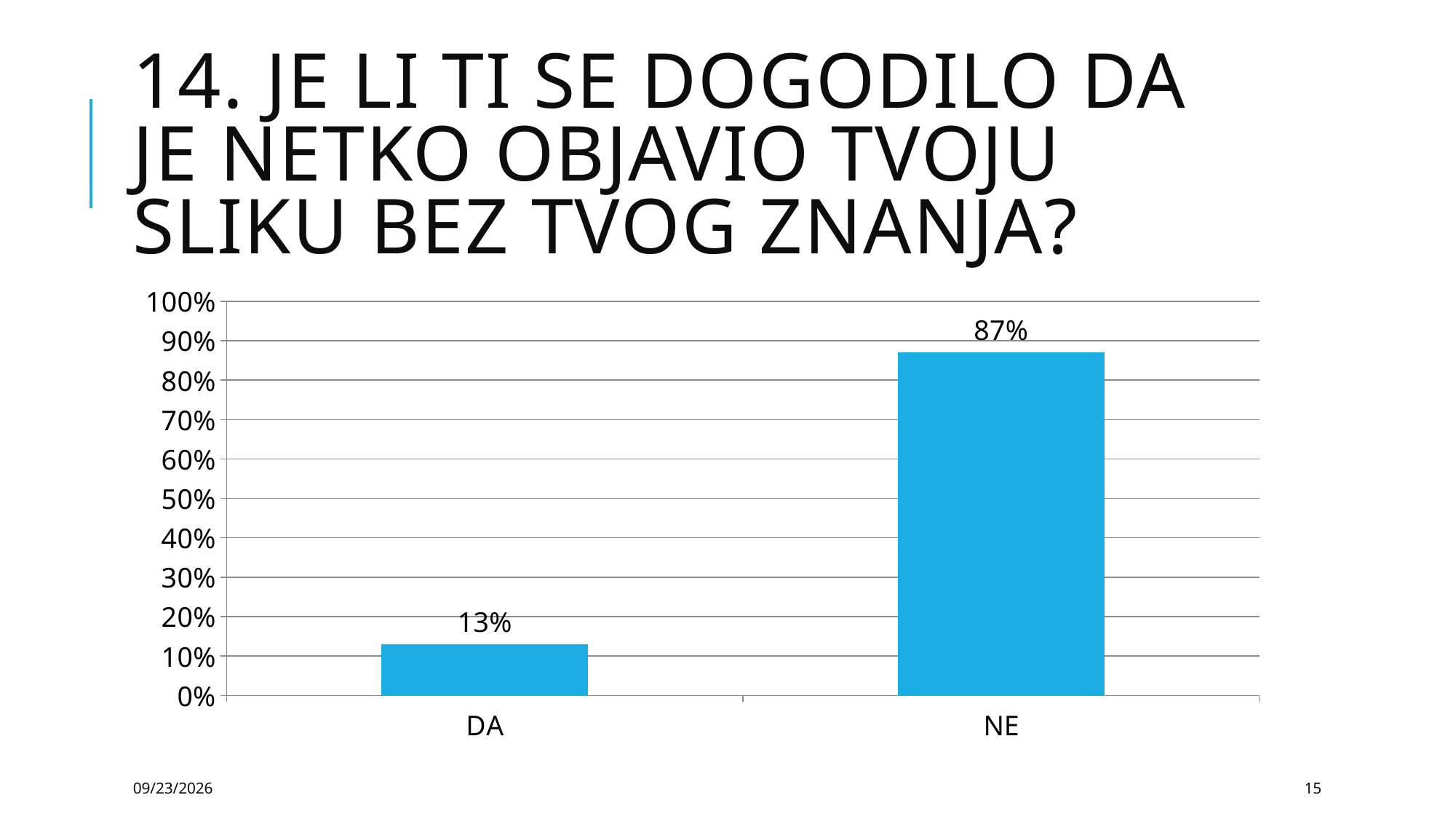
How many categories are shown on the x axis? 2 Which category has the lowest value? DA Is the value for DA greater or less than 20%? less What is the value for DA? 13% Which category has the highest value? NE What is the value for NE? 87% What is the difference between the values for NE and DA? 74% Is the value for NE greater or less than 80%? greater What is the total of the values for DA and NE? 100% What kind of chart is shown on the slide? bar chart What is the maximum value shown on the y axis? 100% Which is larger, the value for DA or the value for NE? NE